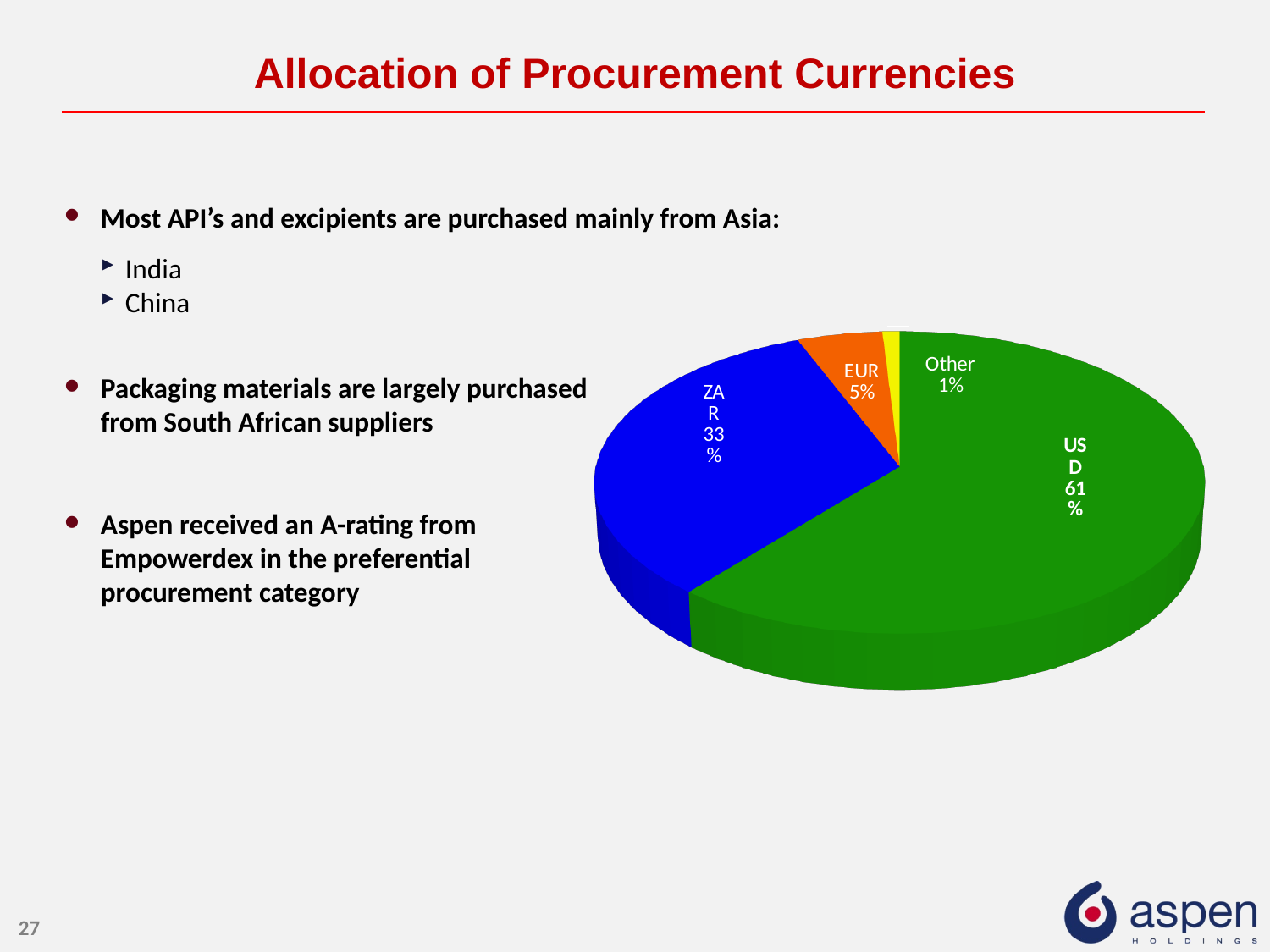
Which currency has the largest share of the pie? USD What kind of chart is shown on the slide? Pie chart What is the difference in percentage points between the USD and ZAR shares? 28 What share of procurement currencies does USD account for? 61% What share of procurement currencies does ZAR account for? 33% Which currency has the smallest share of the pie? Other Which has a larger share, EUR or ZAR? ZAR What share of procurement currencies does Other account for? 1% What colour is the USD slice of the pie? Green What is the combined share of EUR and Other? 6% How many slices does the pie chart have? 4 What share of procurement currencies does EUR account for? 5%